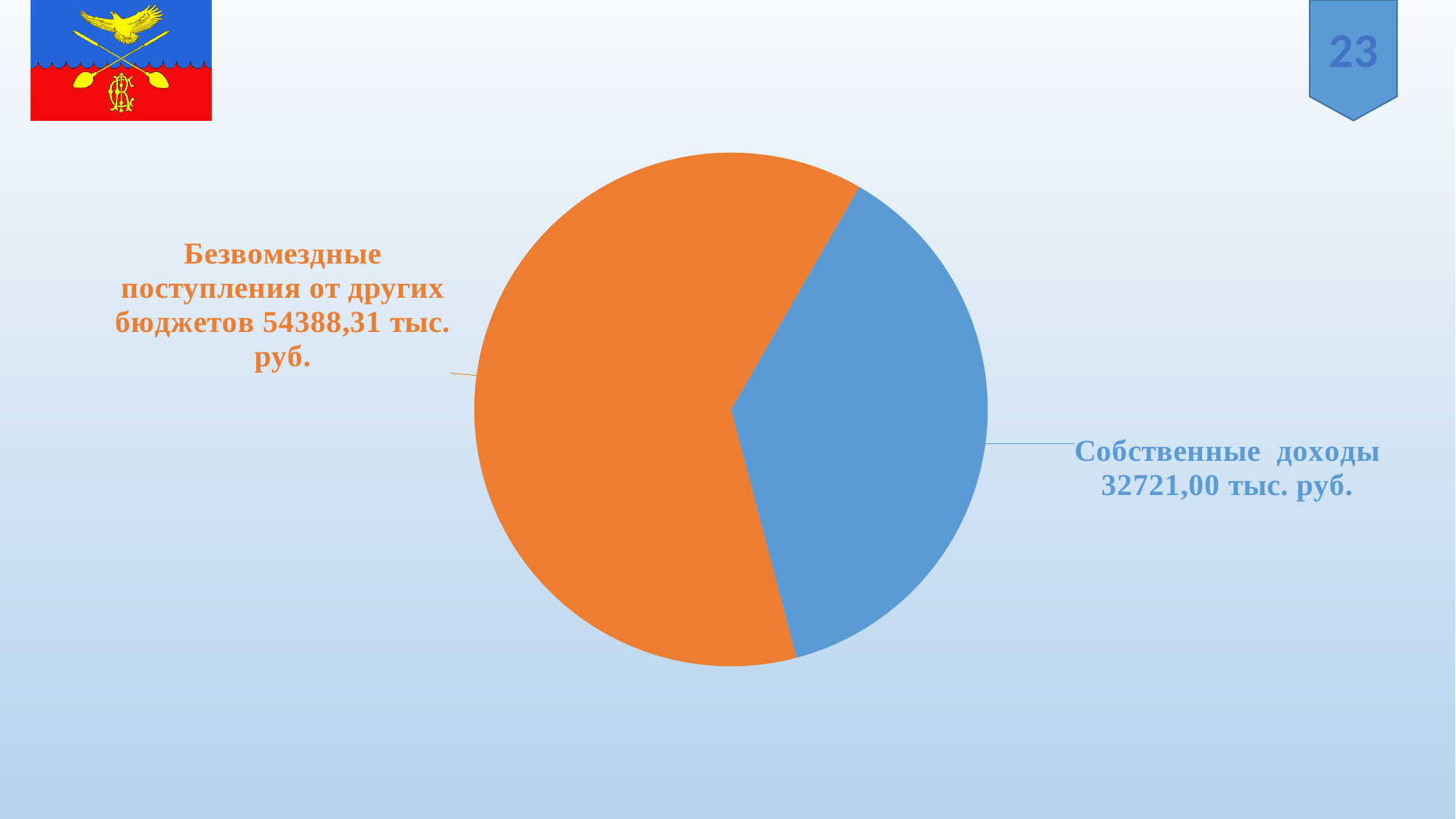
Which slice of the pie chart is the smallest? Собственные доходы What is the value shown for Безвомездные поступления от других бюджетов? 54388,31 тыс. руб. What is the total of the two values shown in the pie chart? 87109,31 тыс. руб. What colour is the slice for Собственные доходы? blue Which is larger: Собственные доходы or Безвомездные поступления от других бюджетов? Безвомездные поступления от других бюджетов Which slice of the pie chart is the largest? Безвомездные поступления от других бюджетов What colour is the slice for Безвомездные поступления от других бюджетов? orange What is the value shown for Собственные доходы? 32721,00 тыс. руб. How many slices does the pie chart have? 2 By how much do Безвомездные поступления от других бюджетов exceed Собственные доходы? 21667,31 тыс. руб. What kind of chart is shown on the slide? pie chart